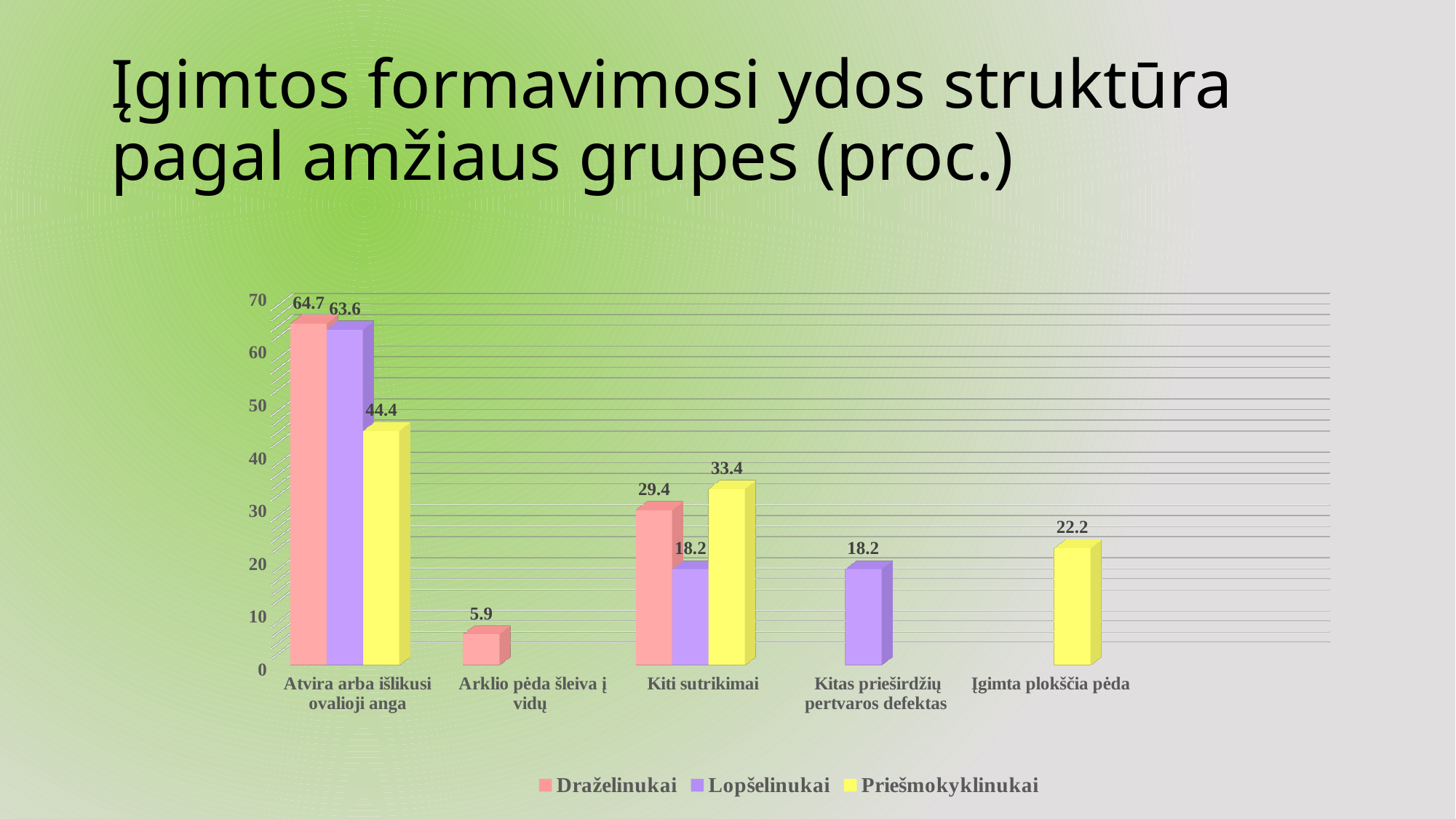
What kind of chart is shown on the slide? bar chart How many categories are shown on the x axis? 5 What is the value for Lopšelinukai in the category Kitas prieširdžių pertvaros defektas? 18.2 How many series does the legend list? 3 Which category has the lowest value for Draželinukai? Arklio pėda šleiva į vidų What is the value for Draželinukai in the category Arklio pėda šleiva į vidų? 5.9 What is the difference between the Draželinukai and Lopšelinukai values in the category Kiti sutrikimai? 11.2 Which category has the highest value for Priešmokyklinukai? Atvira arba išlikusi ovalioji anga What is the value for Draželinukai in the category Atvira arba išlikusi ovalioji anga? 64.7 In the category Kiti sutrikimai, which is larger: the Draželinukai value or the Priešmokyklinukai value? Priešmokyklinukai What is the value for Priešmokyklinukai in the category Kiti sutrikimai? 33.4 Which series is shown in yellow in the legend? Priešmokyklinukai